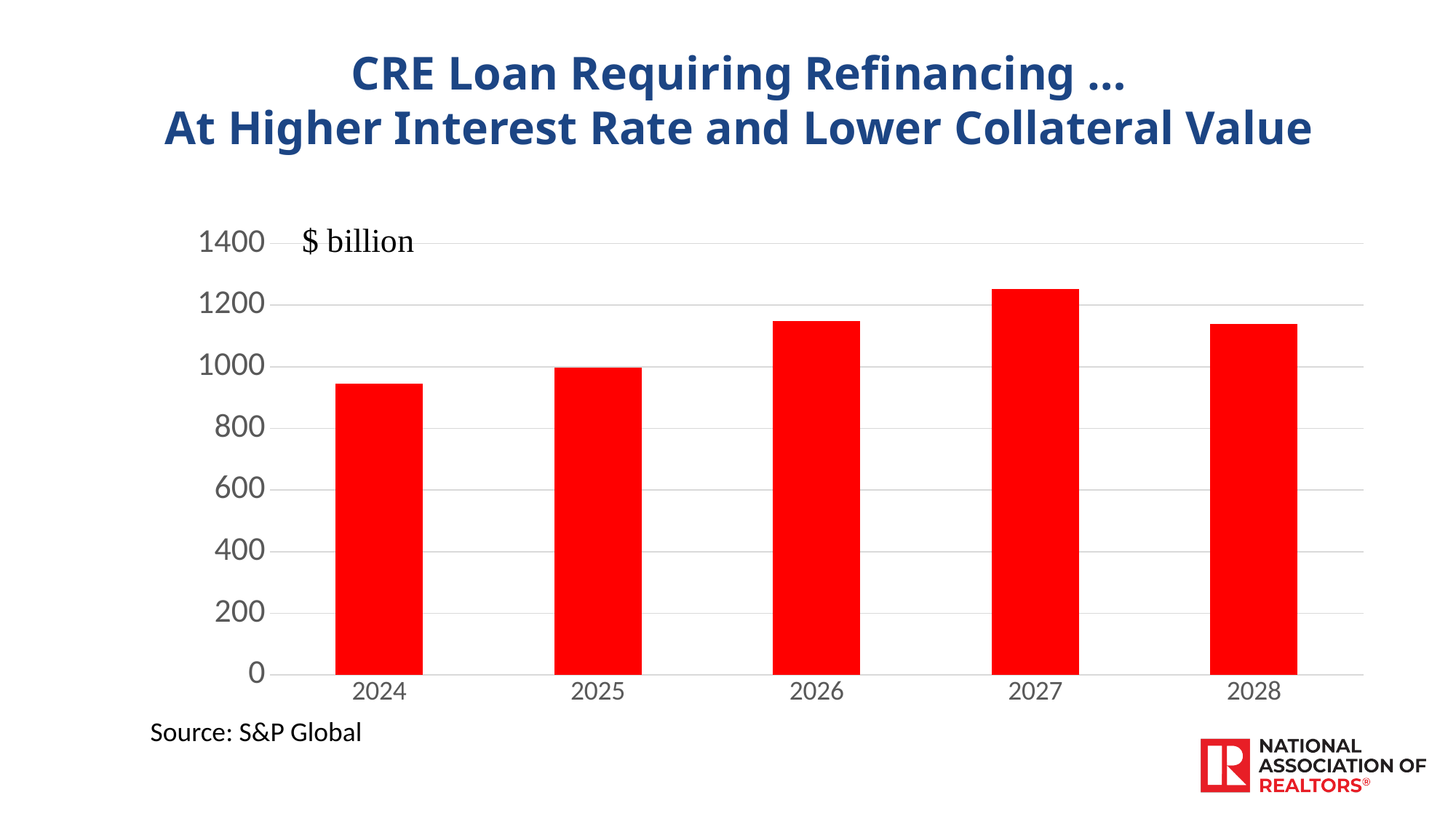
Is the value for 2026 greater or less than 1200? less Is the value for 2027 greater or less than 1200? greater Is the value for 2024 greater or less than 1000? less How many years are shown on the x axis of the chart? 5 Which is larger, the value for 2025 or the value for 2026? 2026 Do the values rise or fall from 2024 to 2027? rise Which year has the highest value in the chart? 2027 What source is cited for the chart? S&P Global Which year has the lowest value in the chart? 2024 What kind of chart is shown on the slide? bar chart What unit is indicated on the chart's value axis? $ billion